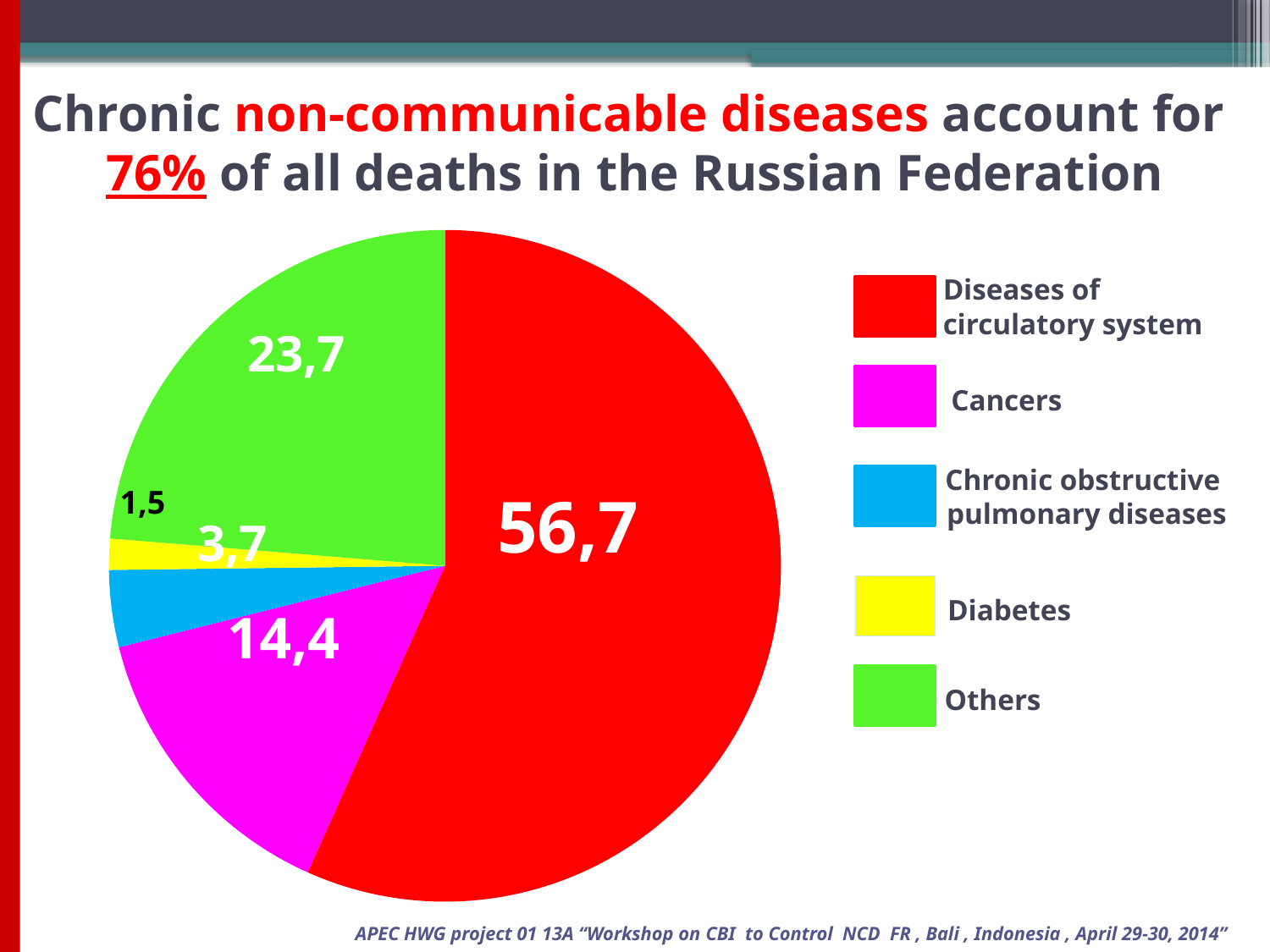
What value is shown for Chronic obstructive pulmonary diseases? 3,7 How many slices does the pie chart have? 5 Which is larger, the value for Others or the value for Cancers? Others What value is shown for Cancers? 14,4 What kind of chart is shown on the slide? pie chart What value is shown for Others? 23,7 What value is shown for Diabetes? 1,5 Which category has the largest slice of the pie? Diseases of circulatory system What is the difference between the values for Diseases of circulatory system and Cancers? 42,3 What value is shown for Diseases of circulatory system? 56,7 What colour is the slice for Diabetes? yellow Which category has the smallest slice of the pie? Diabetes